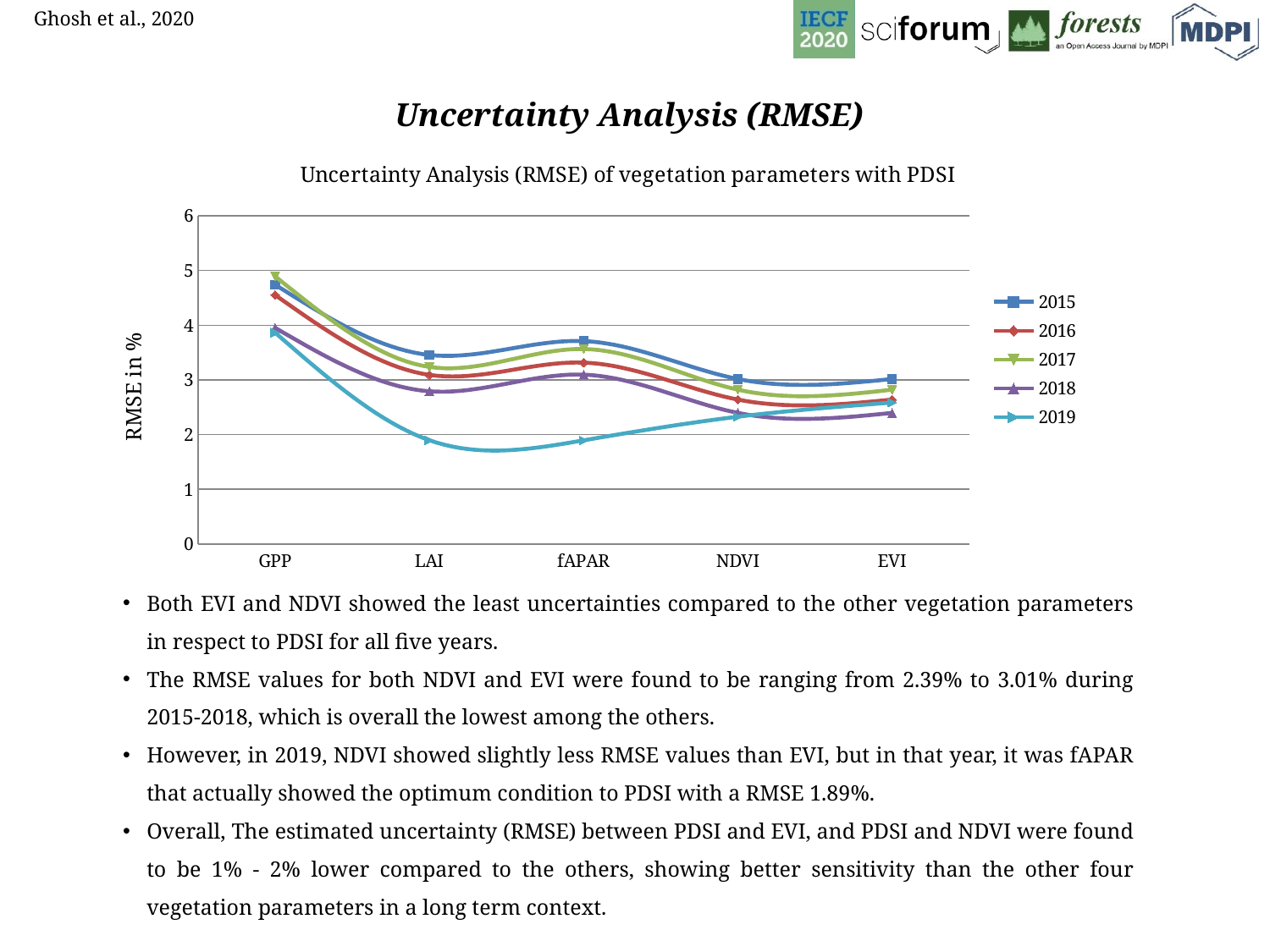
What is the label of the vertical axis? RMSE in % Is the value for 2018 at LAI greater or less than 3? less What is the title of the chart? Uncertainty Analysis (RMSE) of vegetation parameters with PDSI What kind of chart is shown on the slide? line chart Is the value for 2019 at LAI greater or less than 2? less For the 2015 series, which vegetation parameter has the highest RMSE? GPP Is the value for 2015 at GPP greater or less than 4? greater How many vegetation parameters are plotted along the x axis? 5 How many series does the legend list? 5 At LAI, which year has the lowest RMSE? 2019 Does the 2015 series rise or fall from GPP to LAI? fall